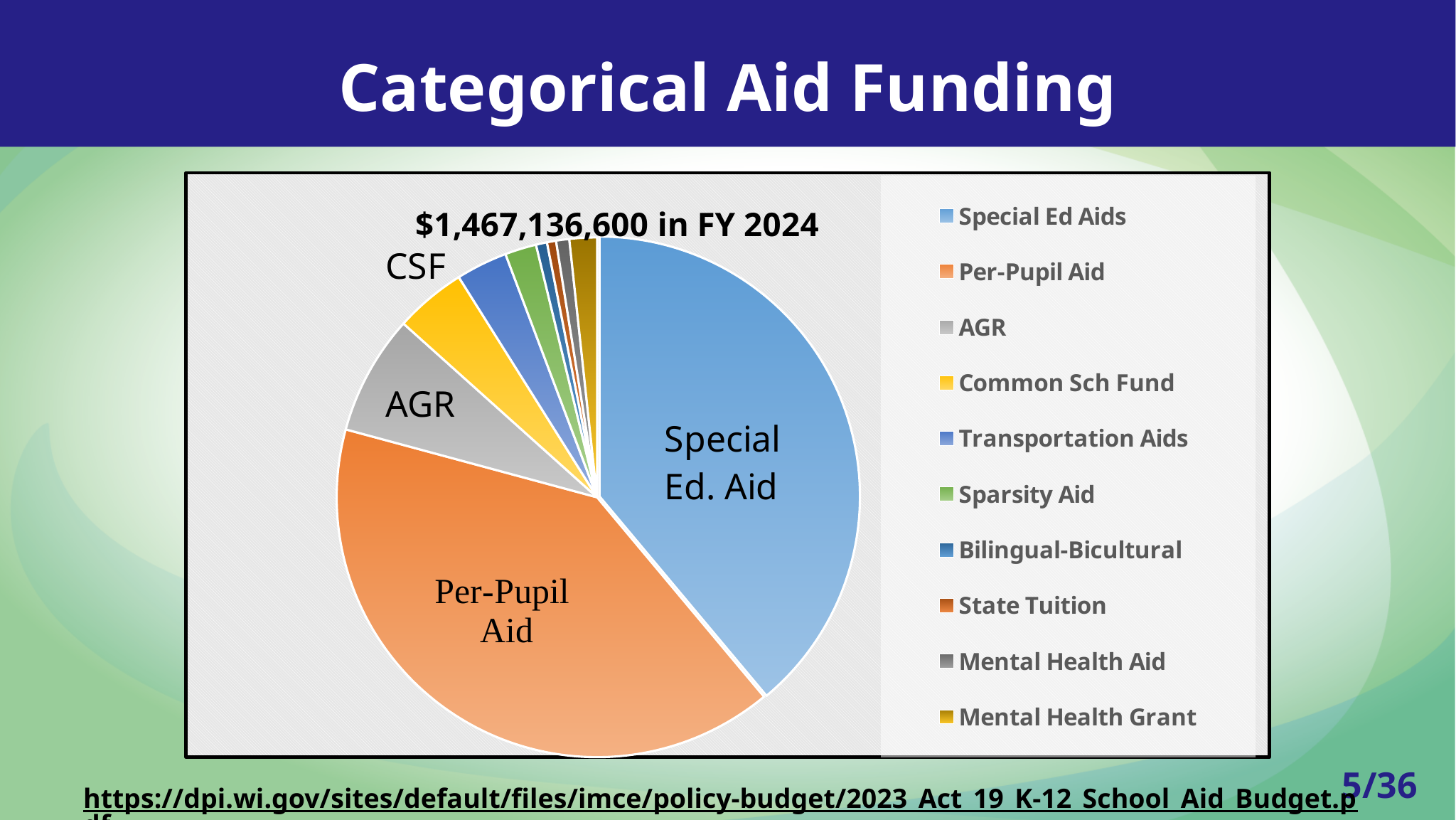
Which slice is larger, Common Sch Fund or Sparsity Aid? Common Sch Fund How many categories does the legend of the pie chart list? 10 Which slice is larger, Transportation Aids or Mental Health Aid? Transportation Aids What kind of chart is shown on the slide? pie chart Which slice is larger, Per-Pupil Aid or AGR? Per-Pupil Aid Which category is shown in orange in the pie chart? Per-Pupil Aid What total amount does the chart title state for FY 2024? $1,467,136,600 Which category has the largest slice of the pie chart? Per-Pupil Aid